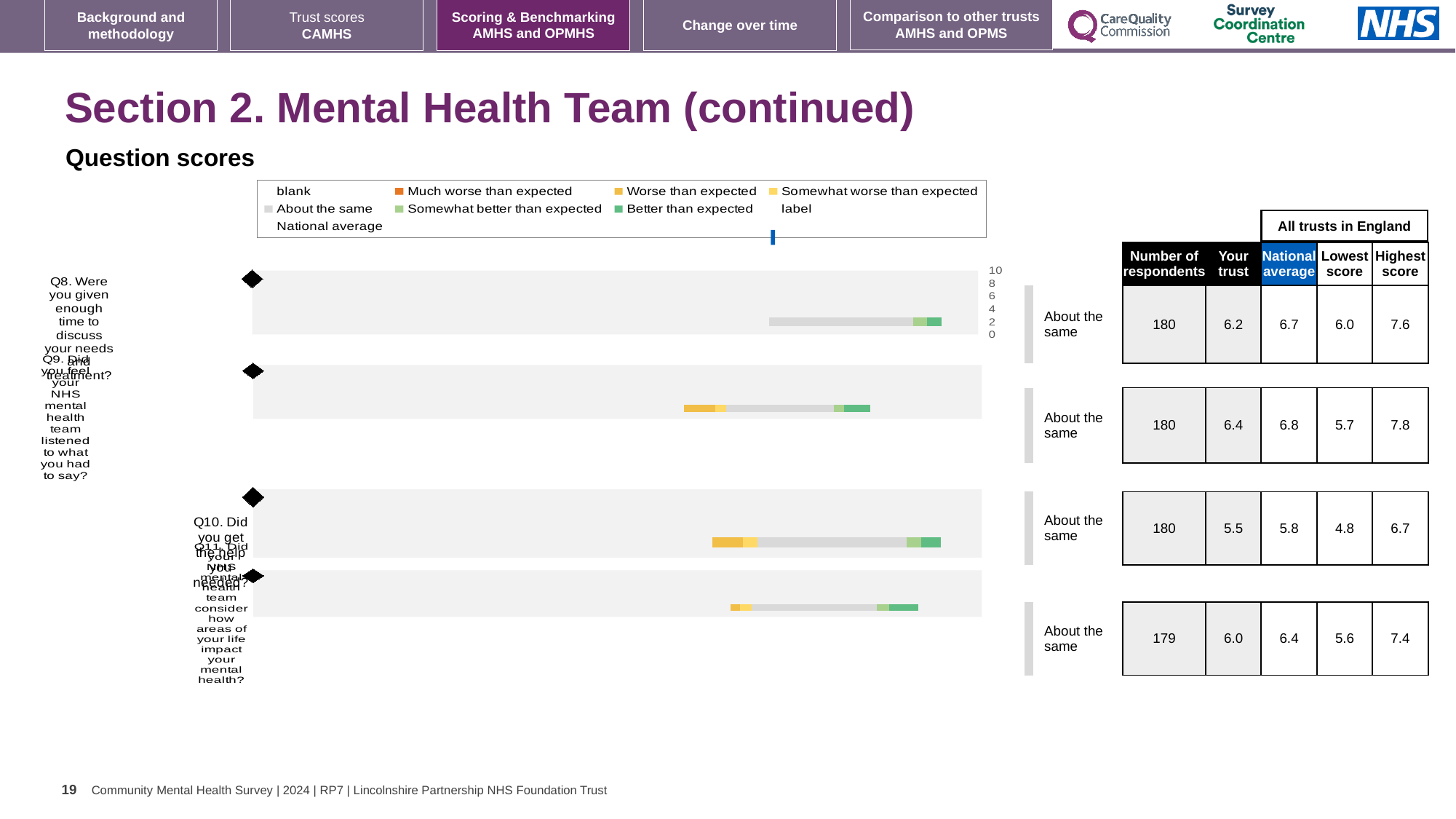
What colour does the legend use for 'Much worse than expected'? orange How many survey questions (Q8 to Q11) are plotted in the question scores chart? 4 What benchmark category is shown for Q10 (Did you get the help you needed?)? About the same What is the highest score across all trusts in England for Q10 (Did you get the help you needed?)? 6.7 Which question has the highest 'Your trust' score? Q9 What is the difference between the highest score (7.8) and the lowest score (5.7) for Q9? 2.1 Is the 'Your trust' score larger for Q8 or for Q9? Q9 Which question has the lowest 'Your trust' score? Q10 How many respondents answered Q11 (Did your NHS mental health team consider how areas of your life impact your mental health?)? 179 What is the 'Your trust' score for Q8 (Were you given enough time to discuss your needs and treatment?)? 6.2 What kind of chart is used to show the question scores on this slide? bar chart What is the national average score for Q9 (Did you feel your NHS mental health team listened to what you had to say?)? 6.8